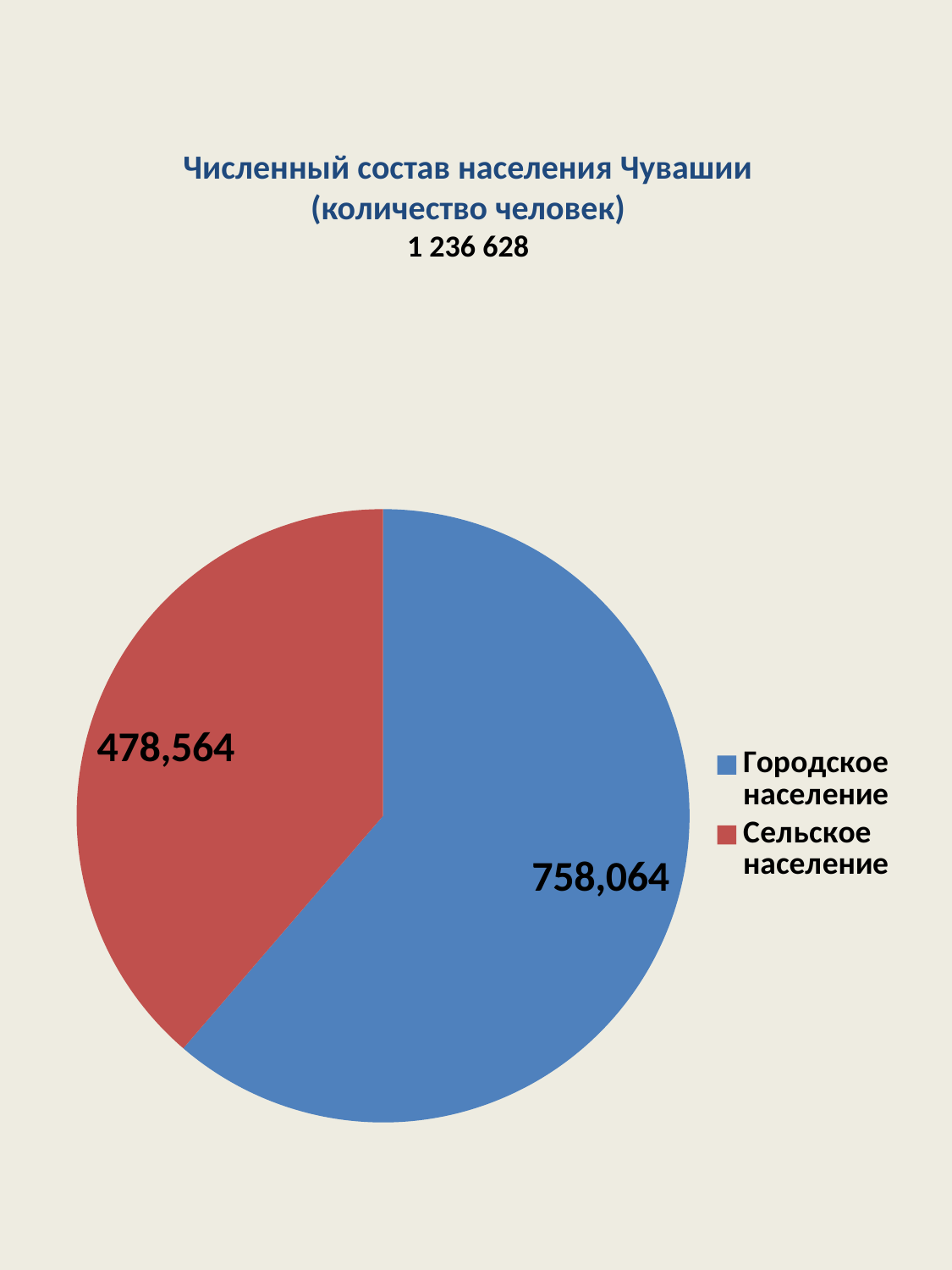
What is the title of the chart? Численный состав населения Чувашии (количество человек) How many entries does the legend list? 2 What total population figure is printed under the chart title? 1 236 628 How many slices does the pie chart have? 2 What is the value for Сельское население? 478,564 Which category has the smallest slice of the pie? Сельское население What is the value for Городское население? 758,064 Which is larger, Городское население or Сельское население? Городское население What colour is the slice for Сельское население? red What kind of chart is shown on the slide? pie chart Which category has the largest slice of the pie? Городское население What is the difference between Городское население and Сельское население? 279,500